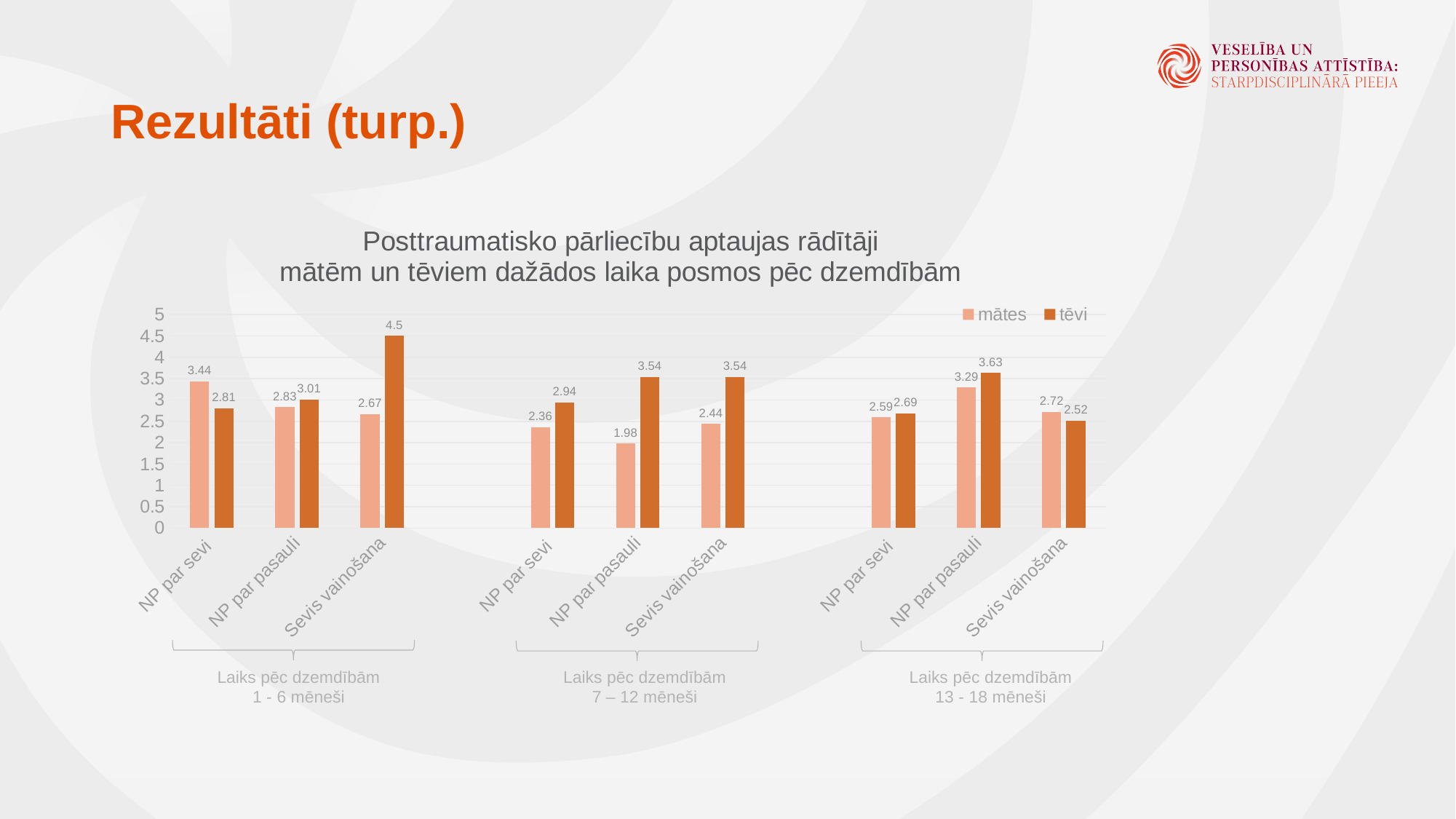
What is the difference between the tēvi and mātes values for "Sevis vainošana" in the period "1 - 6 mēneši"? 1.83 What kind of chart is shown on the slide? Bar chart What is the difference between the tēvi and mātes values for "NP par pasauli" in the period "7 – 12 mēneši"? 1.56 What is the value for mātes for "NP par sevi" in the period "Laiks pēc dzemdībām 1 - 6 mēneši"? 3.44 Which bar has the highest value in the whole chart? tēvi, Sevis vainošana, 1 - 6 mēneši (4.5) How many series does the legend list? 2 What is the value for tēvi for "NP par pasauli" in the period "Laiks pēc dzemdībām 13 - 18 mēneši"? 3.63 Which bar has the lowest value in the whole chart? mātes, NP par pasauli, 7 – 12 mēneši (1.98) What is the value for mātes for "NP par pasauli" in the period "Laiks pēc dzemdībām 7 – 12 mēneši"? 1.98 What is the value for tēvi for "Sevis vainošana" in the period "Laiks pēc dzemdībām 1 - 6 mēneši"? 4.5 In the period "13 - 18 mēneši", which is larger for "Sevis vainošana": mātes or tēvi? mātes How many time periods after birth are shown on the x axis? 3